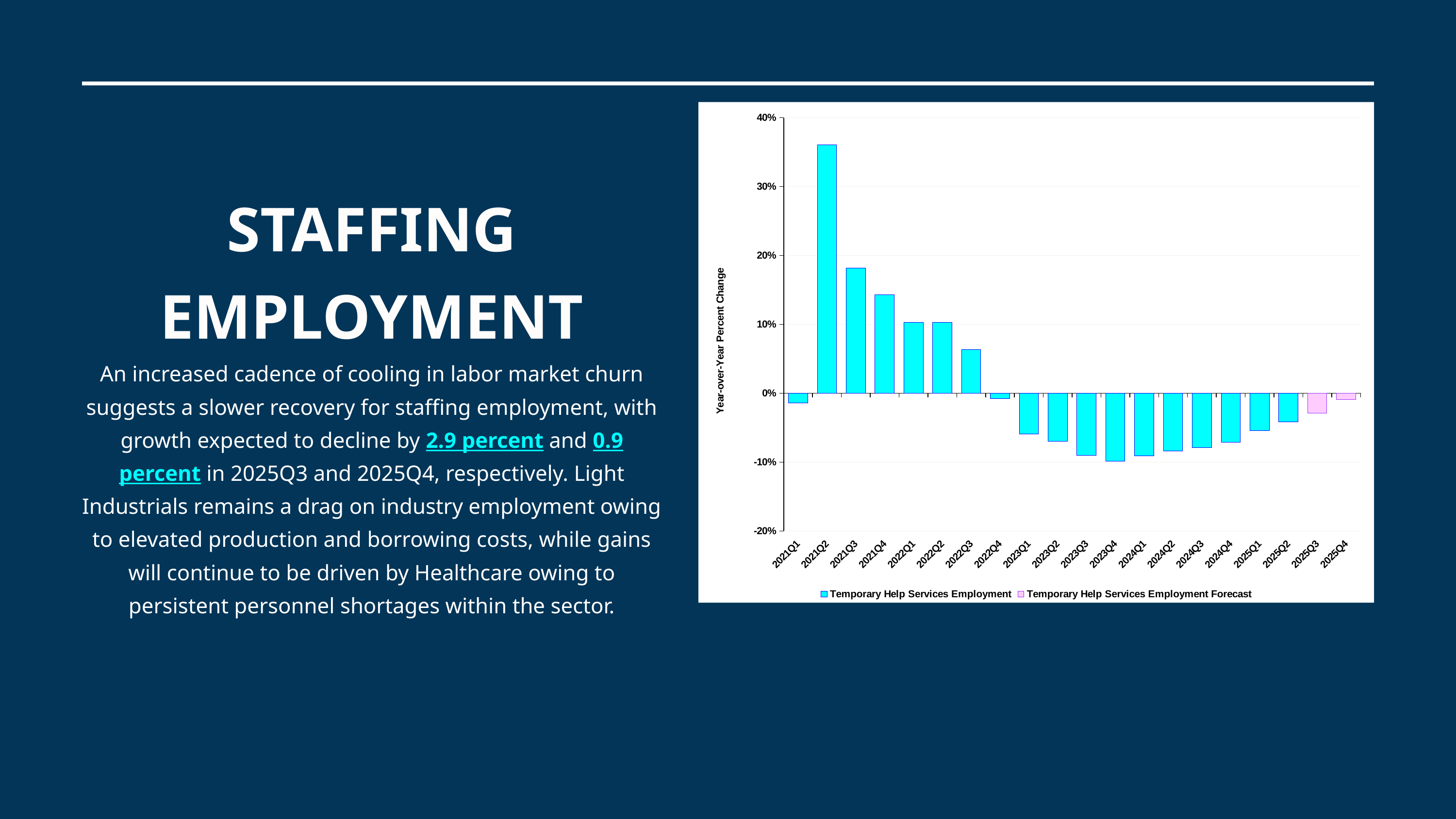
Is the value for 2021Q4 greater or less than 10%? greater Which is larger, the value for 2021Q3 or the value for 2021Q4? 2021Q3 Do the values rise or fall from 2021Q2 to 2023Q4? fall How many quarters are plotted along the x axis of the chart? 20 What is the title of the chart's vertical axis? Year-over-Year Percent Change Which quarter has the highest year-over-year percent change in the chart? 2021Q2 Is the value for 2021Q2 greater or less than 30%? greater Is the value for 2023Q4 greater or less than -5%? less What kind of chart is shown on the slide? bar chart Which quarters are shown as Temporary Help Services Employment Forecast bars? 2025Q3 and 2025Q4 How many series does the chart's legend list? 2